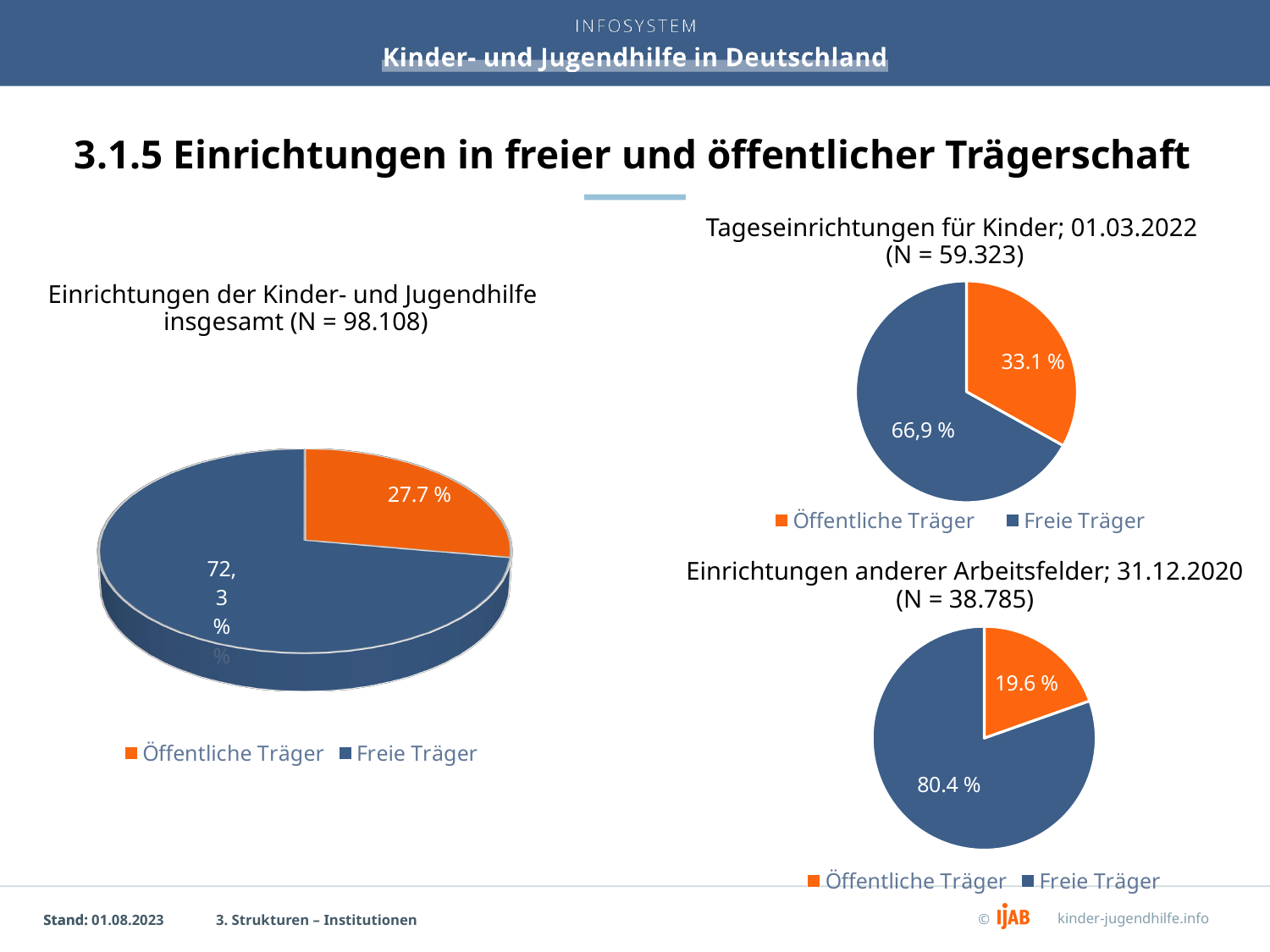
How many categories does the legend of the chart 'Tageseinrichtungen für Kinder; 01.03.2022' list? 2 In the chart titled 'Einrichtungen anderer Arbeitsfelder; 31.12.2020', what share is shown for Öffentliche Träger? 19.6 % What kind of chart is used for 'Einrichtungen der Kinder- und Jugendhilfe insgesamt'? Pie chart Is the share of Öffentliche Träger larger in the chart 'Tageseinrichtungen für Kinder; 01.03.2022' or in the chart 'Einrichtungen anderer Arbeitsfelder; 31.12.2020'? Tageseinrichtungen für Kinder; 01.03.2022 In the chart titled 'Tageseinrichtungen für Kinder; 01.03.2022', which category has the smaller share? Öffentliche Träger In the chart titled 'Tageseinrichtungen für Kinder; 01.03.2022', what share is shown for Öffentliche Träger? 33.1 % In the chart titled 'Einrichtungen anderer Arbeitsfelder; 31.12.2020', which category has the larger share? Freie Träger In the chart titled 'Tageseinrichtungen für Kinder; 01.03.2022', what share is shown for Freie Träger? 66,9 % In the chart titled 'Einrichtungen anderer Arbeitsfelder; 31.12.2020', what is the difference in percentage points between Freie Träger and Öffentliche Träger? 60.8 In the chart titled 'Einrichtungen anderer Arbeitsfelder; 31.12.2020', what share is shown for Freie Träger? 80.4 % What is the N value given in the title of the chart 'Einrichtungen anderer Arbeitsfelder; 31.12.2020'? 38.785 In the chart titled 'Einrichtungen der Kinder- und Jugendhilfe insgesamt', what share is shown for Öffentliche Träger? 27.7 %